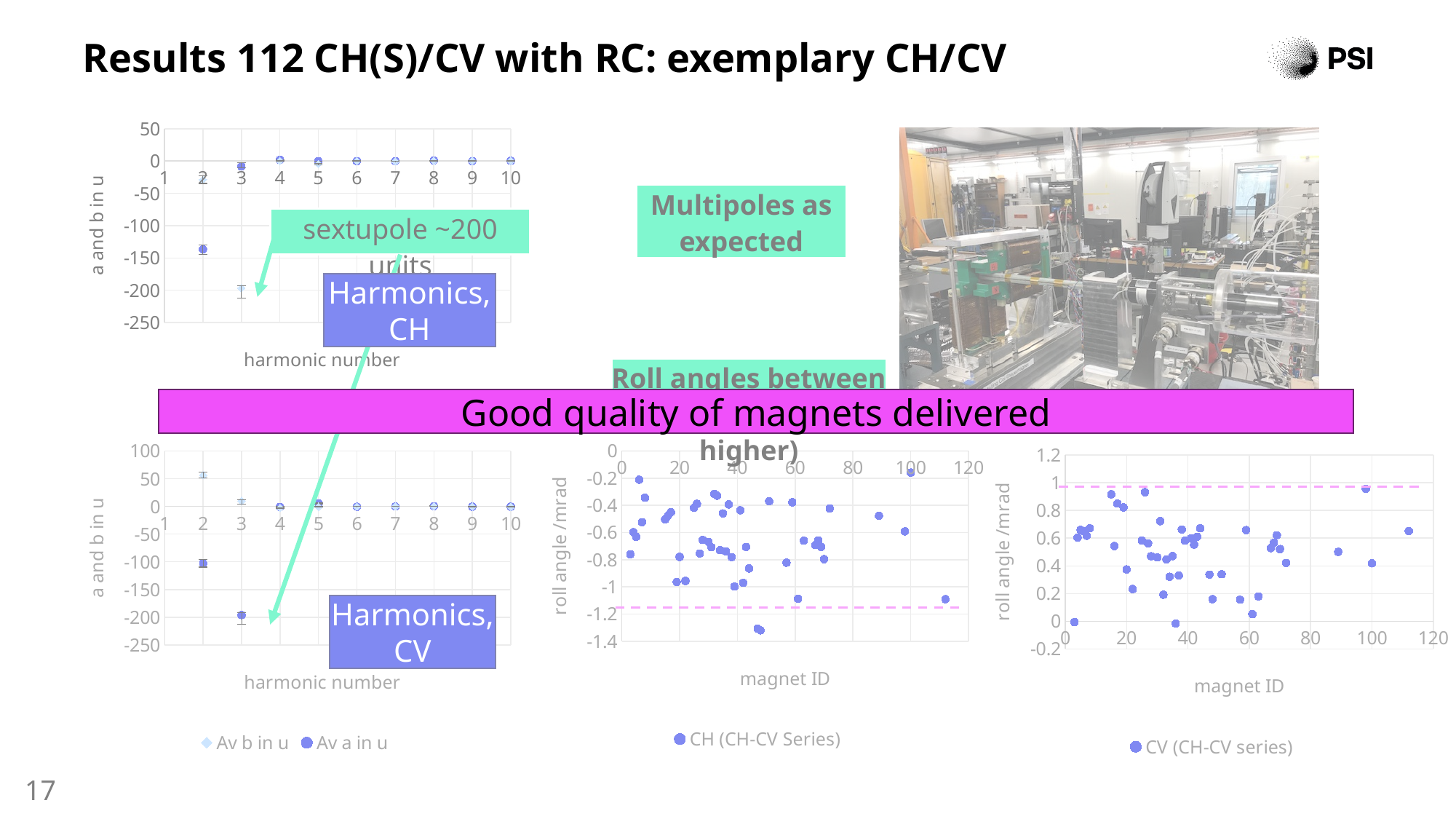
What is the x-axis label of the bottom-right roll angle chart? magnet ID What kind of chart is the 'Harmonics, CH' chart at the top left of the slide? scatter plot In the 'Harmonics, CH' chart, which harmonic number has the lowest value? 3 What is the y-axis label of the roll angle chart at the bottom middle of the slide? roll angle /mrad In the 'Harmonics, CV' chart, which harmonic number has the lowest value? 3 How many harmonic numbers are shown on the x axis of the 'Harmonics, CV' chart? 10 How many series does the legend of the 'Harmonics, CV' chart list? 2 In the 'Harmonics, CV' chart, is the 'Av a in u' value at harmonic number 3 greater or less than -150? less What series name does the legend of the bottom-right roll angle chart show? CV (CH-CV series)